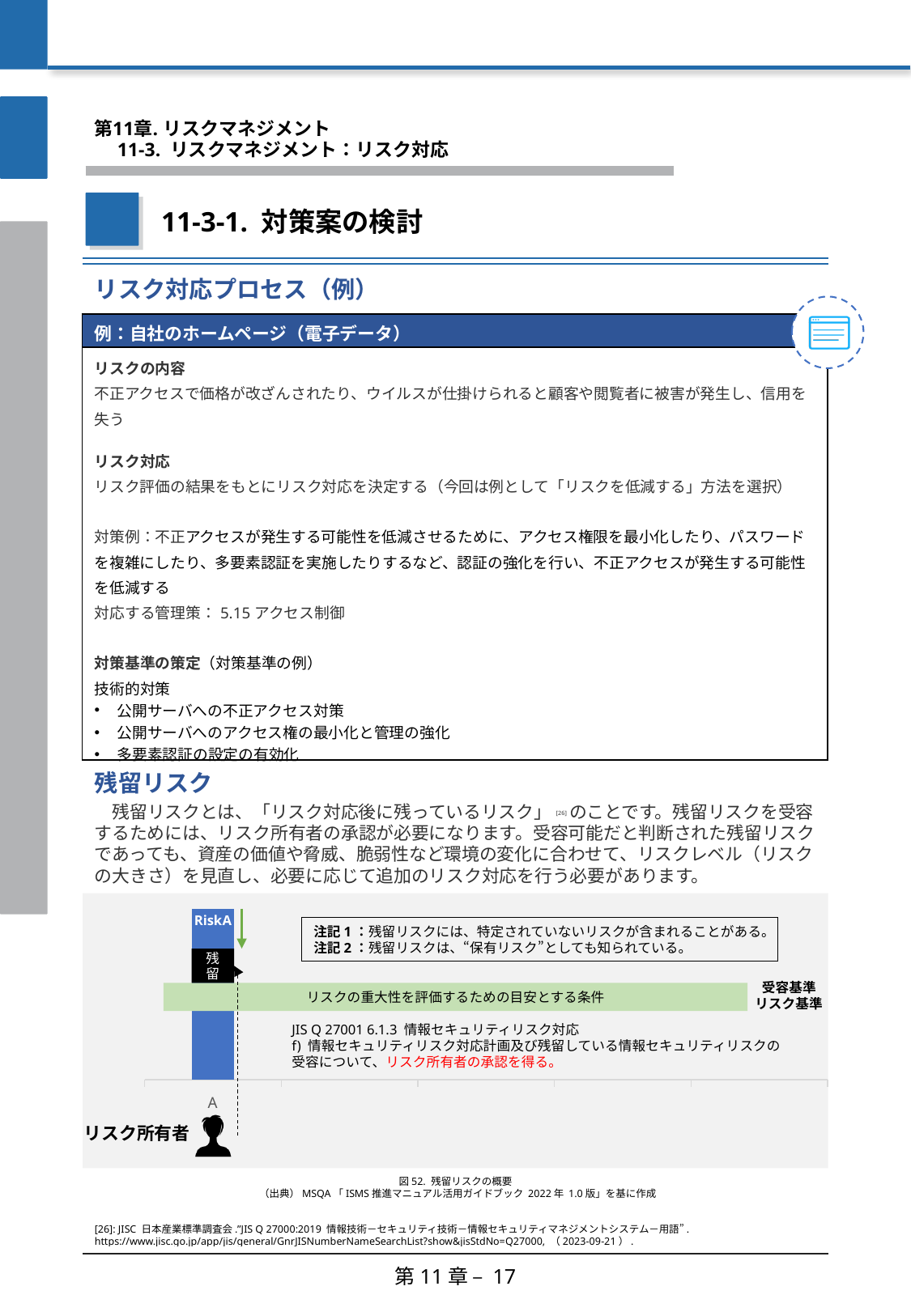
What kind of chart is shown in the figure at the bottom of the slide (図52)? bar chart What is the category label shown on the x axis under the bar in 図52? A What is the caption (figure title) of the chart at the bottom of the slide? 図52. 残留リスクの概要 How many bars are plotted in the chart in 図52? 1 What label is printed at the top of the bar in 図52? RiskA